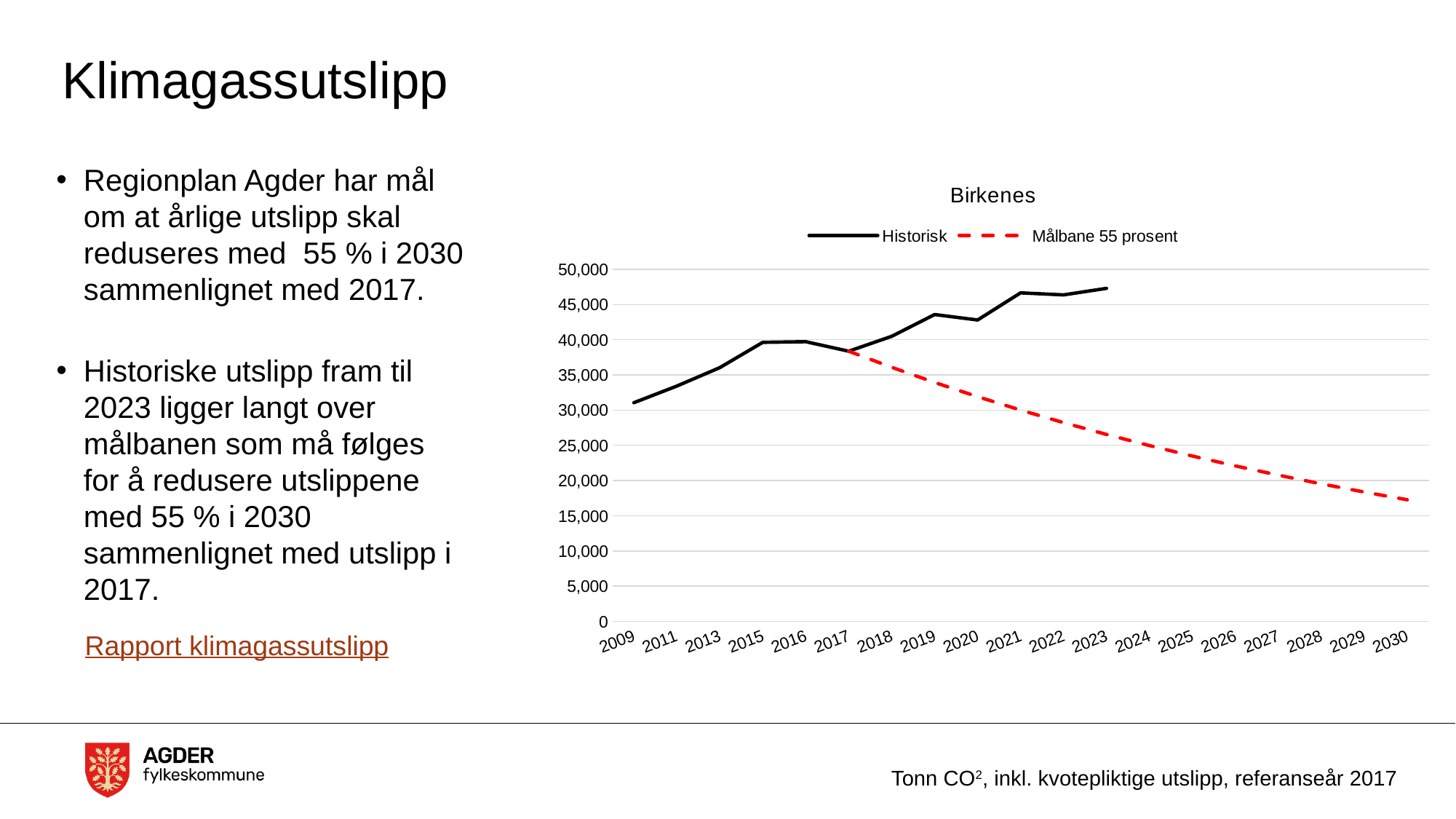
How many year labels are shown on the x axis? 19 In 2023, which is larger: the Historisk value or the Målbane 55 prosent value? Historisk Is the Historisk value for 2023 greater or less than 45,000? greater Is the Historisk value for 2019 greater or less than 40,000? greater In which year is the Historisk series at its lowest? 2009 Which series is drawn as a red dashed line? Målbane 55 prosent Is the Målbane 55 prosent value for 2030 greater or less than 20,000? less What kind of chart is shown on the slide? Line chart How many series does the chart legend list? 2 Does the Målbane 55 prosent series rise or fall from 2017 to 2030? Falls What is the title of the chart? Birkenes